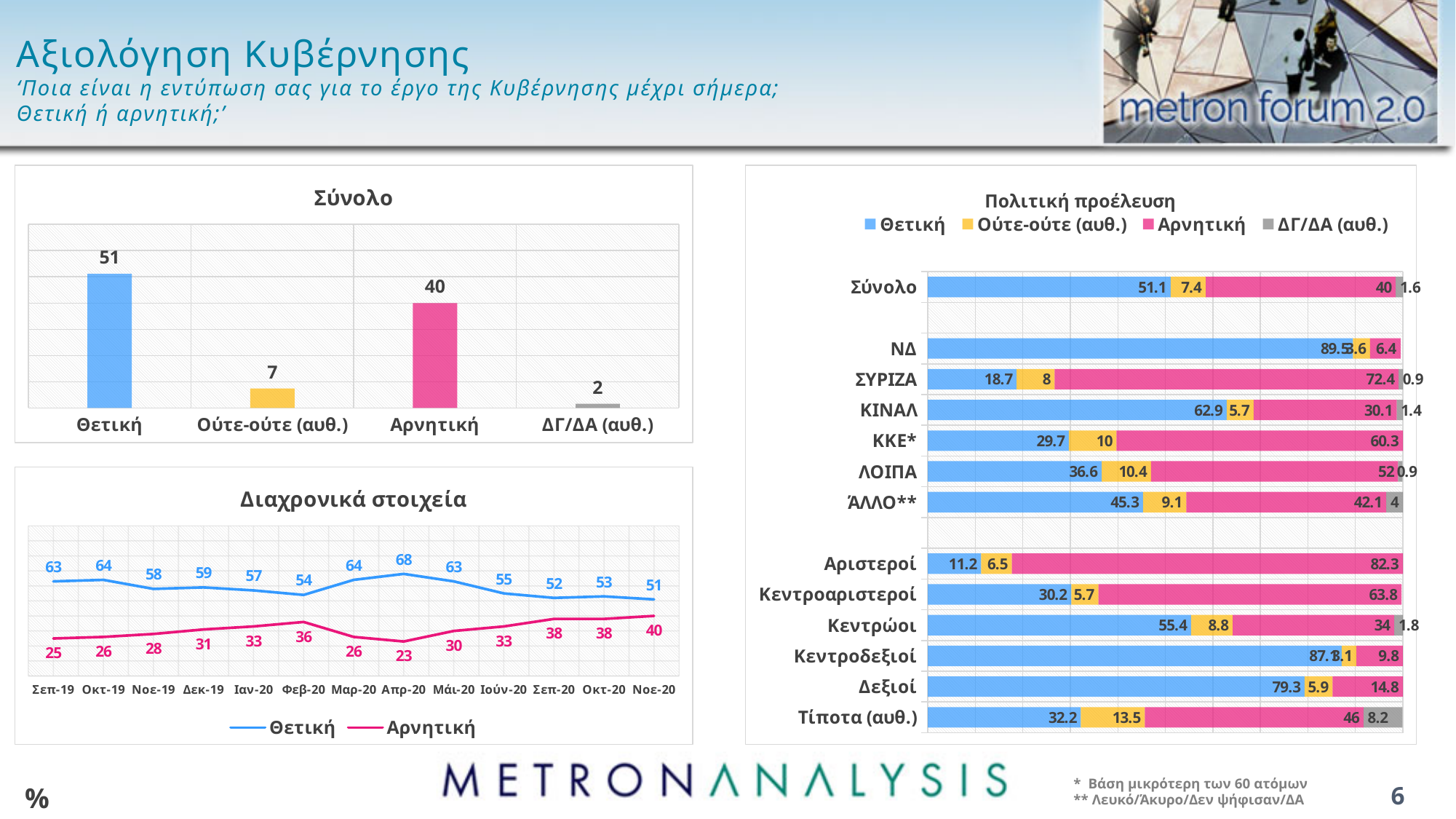
In the 'Σύνολο' chart, how many categories are shown? 4 In the 'Πολιτική προέλευση' chart, which is larger: the Θετική value for Δεξιοί or for Κεντρώοι? Δεξιοί In the 'Πολιτική προέλευση' chart, how many series does the legend list? 4 In the 'Διαχρονικά στοιχεία' chart, in which month is the Αρνητική line at its lowest? Απρ-20 In the 'Διαχρονικά στοιχεία' chart, what is the Αρνητική value for Νοε-20? 40 In the 'Διαχρονικά στοιχεία' chart, what is the Θετική value for Απρ-20? 68 In the 'Σύνολο' chart, what is the difference between Θετική and Αρνητική? 11 In the 'Διαχρονικά στοιχεία' chart, how many time points are plotted? 13 What type of chart is 'Διαχρονικά στοιχεία'? Line chart In the 'Πολιτική προέλευση' chart, what is the Αρνητική value for ΣΥΡΙΖΑ? 72.4 In the 'Σύνολο' chart, what is the value for Θετική? 51 In the 'Σύνολο' chart, which category has the lowest value? ΔΓ/ΔΑ (αυθ.)